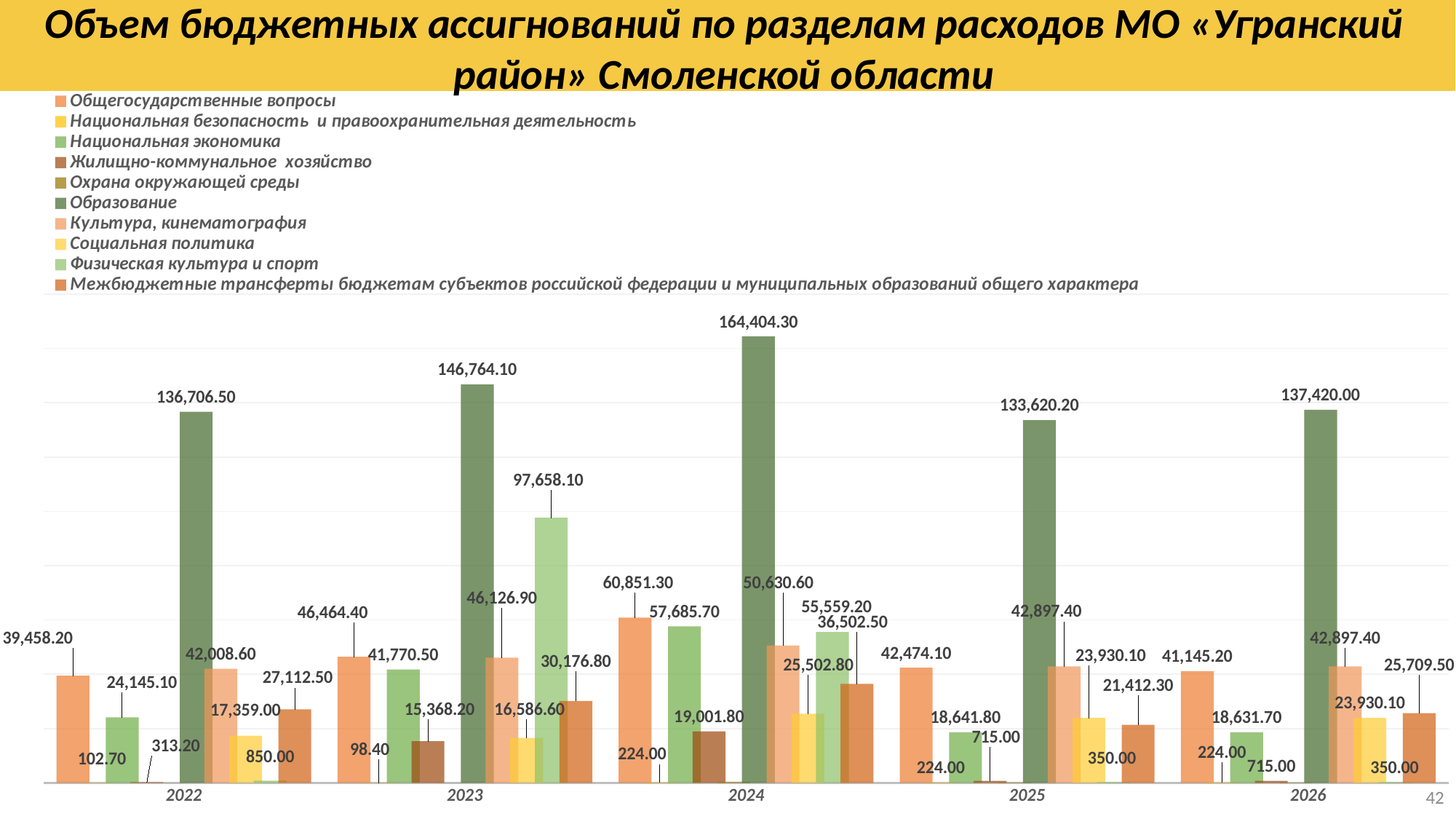
What is the value for Межбюджетные трансферты бюджетам субъектов российской федерации и муниципальных образований общего характера in 2026? 25,709.50 How many years are shown along the x axis? 5 How many series does the legend list? 10 In 2024, which is larger: Общегосударственные вопросы or Национальная экономика? Общегосударственные вопросы What kind of chart is shown on the slide? Bar chart What is the difference between the Культура, кинематография values for 2024 and 2023? 4,503.70 In which year is the value for Образование the lowest? 2025 In which year is the value for Образование the highest? 2024 What is the value for Физическая культура и спорт in 2023? 97,658.10 What is the value for Образование in 2024? 164,404.30 What is the difference between the Образование values for 2024 and 2023? 17,640.20 Does the value for Общегосударственные вопросы rise or fall from 2024 to 2026? Fall